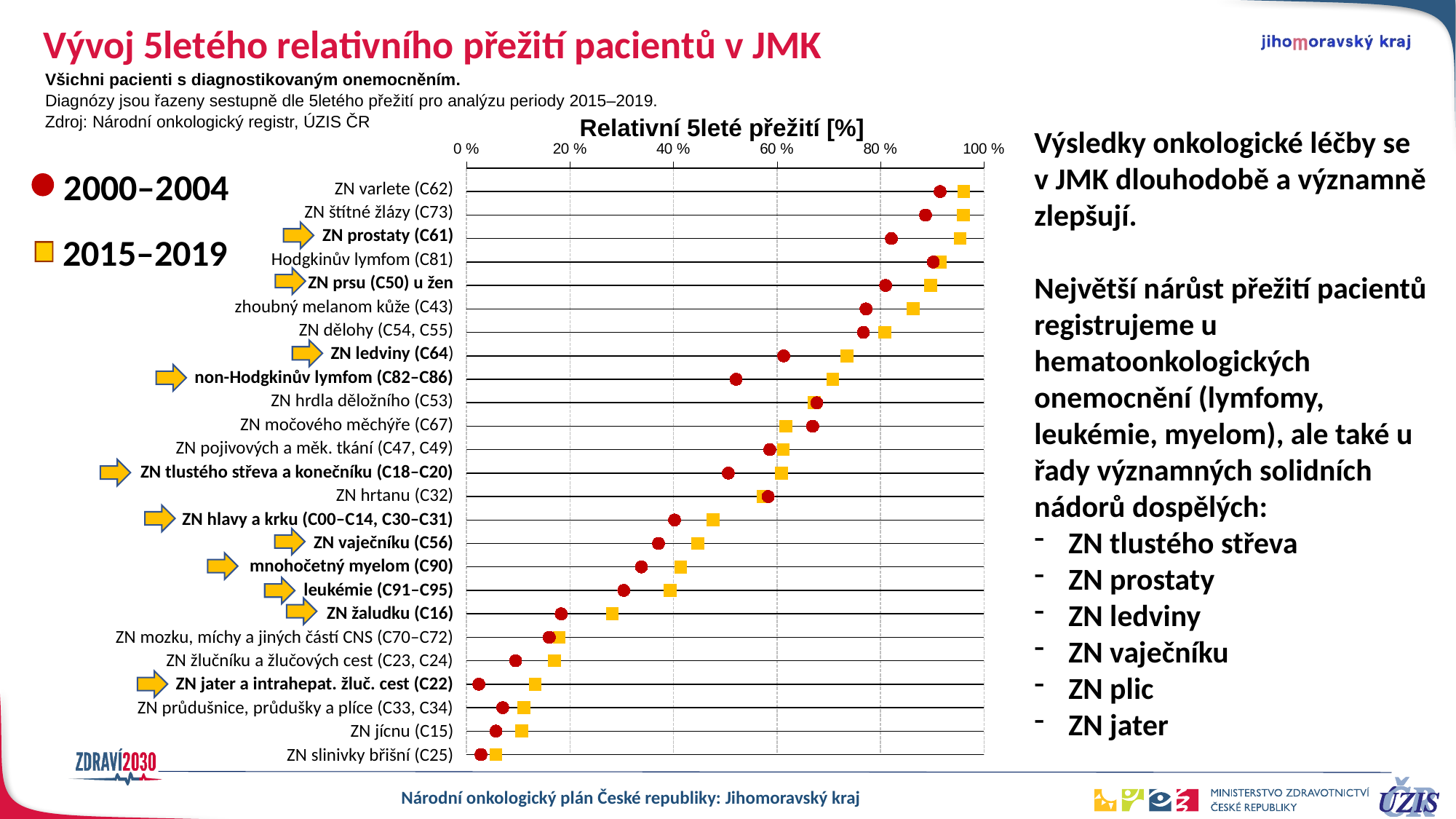
How many diagnoses (categories) are plotted on the chart? 25 Is the 2015–2019 value for ZN slinivky břišní (C25) greater or less than 20 %? less What is the title of the chart's value axis? Relativní 5leté přežití [%] Is the 2000–2004 value for ZN žaludku (C16) greater or less than 20 %? less For ZN močového měchýře (C67), which period has the higher relative 5-year survival, 2000–2004 or 2015–2019? 2000–2004 How many series does the legend list? 2 Is the 2015–2019 value for ZN prostaty (C61) greater or less than 80 %? greater For ZN prostaty (C61), which period has the higher relative 5-year survival, 2000–2004 or 2015–2019? 2015–2019 What kind of chart is shown on the slide? dot plot (scatter chart) Which diagnosis has the lowest 2015–2019 relative 5-year survival? ZN slinivky břišní (C25) Which diagnosis has the highest 2015–2019 relative 5-year survival? ZN varlete (C62)